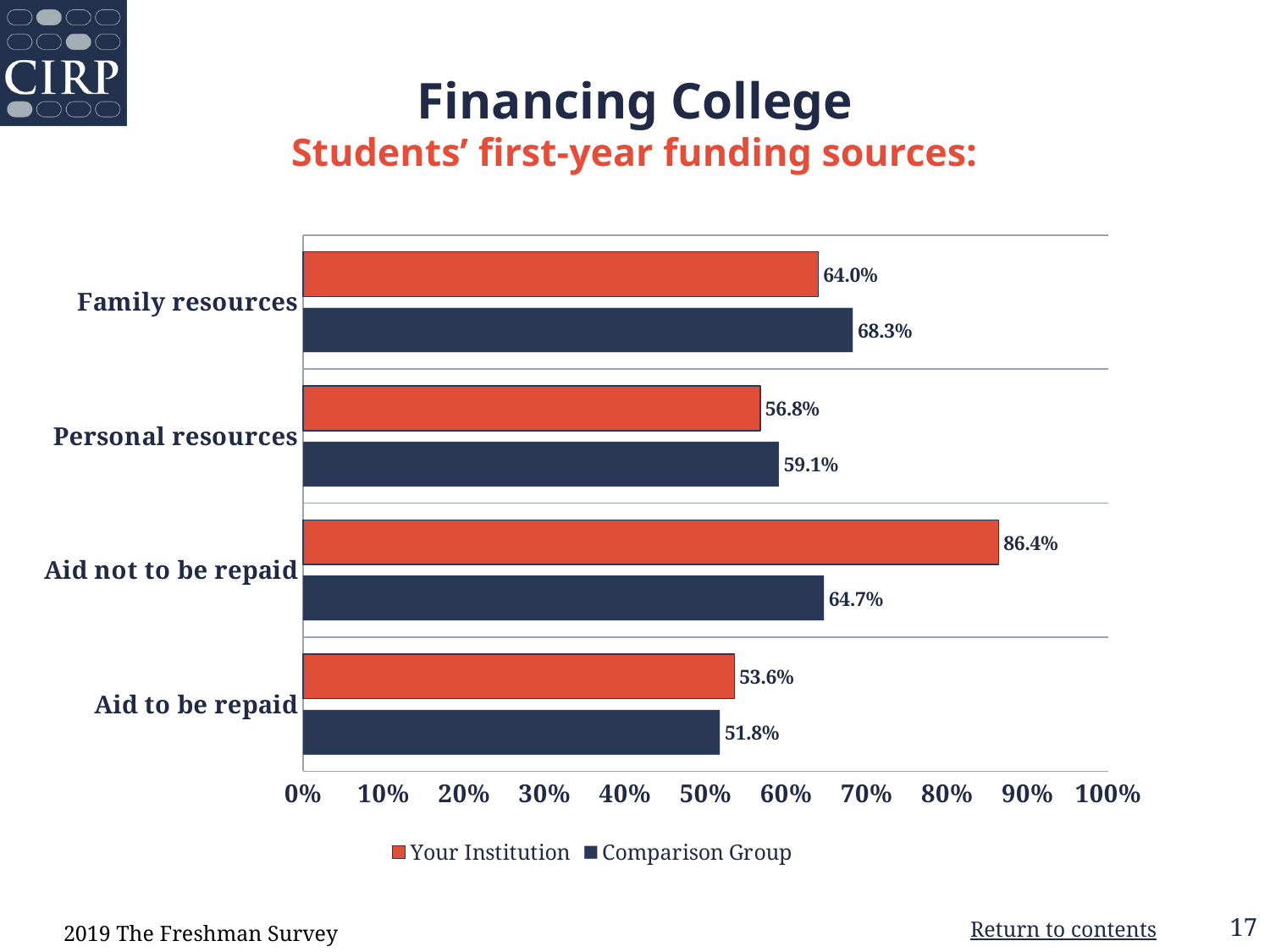
What is the value for Comparison Group for Aid to be repaid? 51.8% How many funding source categories are shown on the chart? 4 Which category has the highest value for Your Institution? Aid not to be repaid Which is larger for Personal resources: Your Institution or Comparison Group? Comparison Group Which category has the lowest value for Comparison Group? Aid to be repaid How many series does the legend list? 2 Which series is shown in orange-red bars? Your Institution What is the difference between Your Institution and Comparison Group for Aid not to be repaid? 21.7% What is the value for Comparison Group for Aid not to be repaid? 64.7% Is the value for Your Institution for Aid not to be repaid greater or less than 80%? greater What is the value for Your Institution for Family resources? 64.0% What kind of chart is shown on the slide? Bar chart